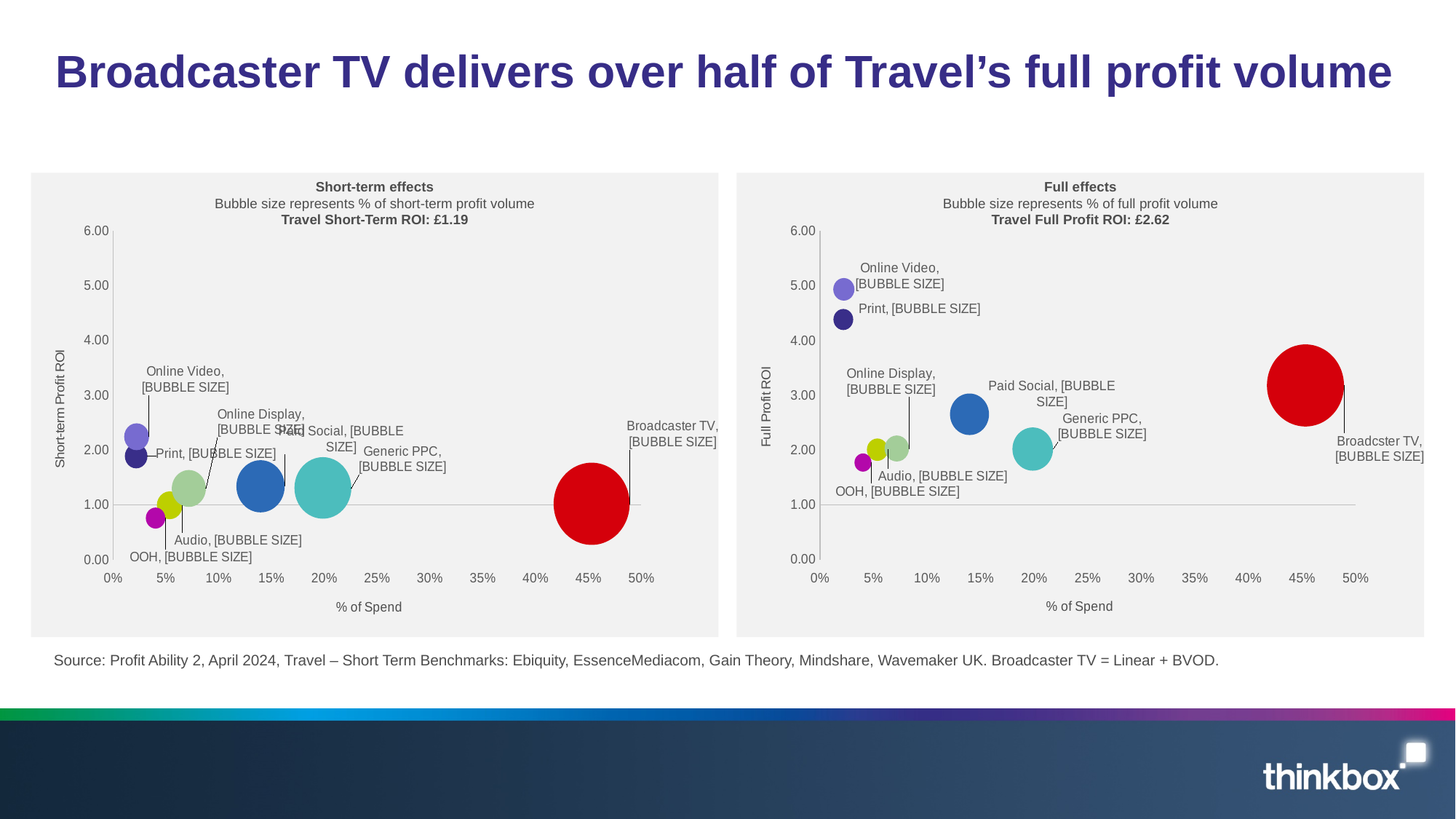
On the 'Short-term effects' chart, which category has the highest % of Spend? Broadcaster TV On the 'Full effects' chart, is the Full Profit ROI for Online Video greater or less than 4.00? greater On the 'Full effects' chart, which category has the highest Full Profit ROI? Online Video On the 'Full effects' chart, which has the higher Full Profit ROI: Broadcaster TV or Paid Social? Broadcaster TV What Travel Full Profit ROI is stated in the title of the 'Full effects' chart? £2.62 On the 'Full effects' chart, is the Full Profit ROI for Broadcaster TV greater or less than 2.00? greater On the 'Short-term effects' chart, which has the higher Short-term Profit ROI: Online Video or Print? Online Video What kind of chart is the 'Short-term effects' chart? Bubble chart On the 'Short-term effects' chart, which category has the lowest Short-term Profit ROI? OOH How many media categories are plotted on the 'Full effects' chart? 8 What Travel Short-Term ROI is stated in the title of the 'Short-term effects' chart? £1.19 On the 'Short-term effects' chart, is the % of Spend for Broadcaster TV greater or less than 40%? greater